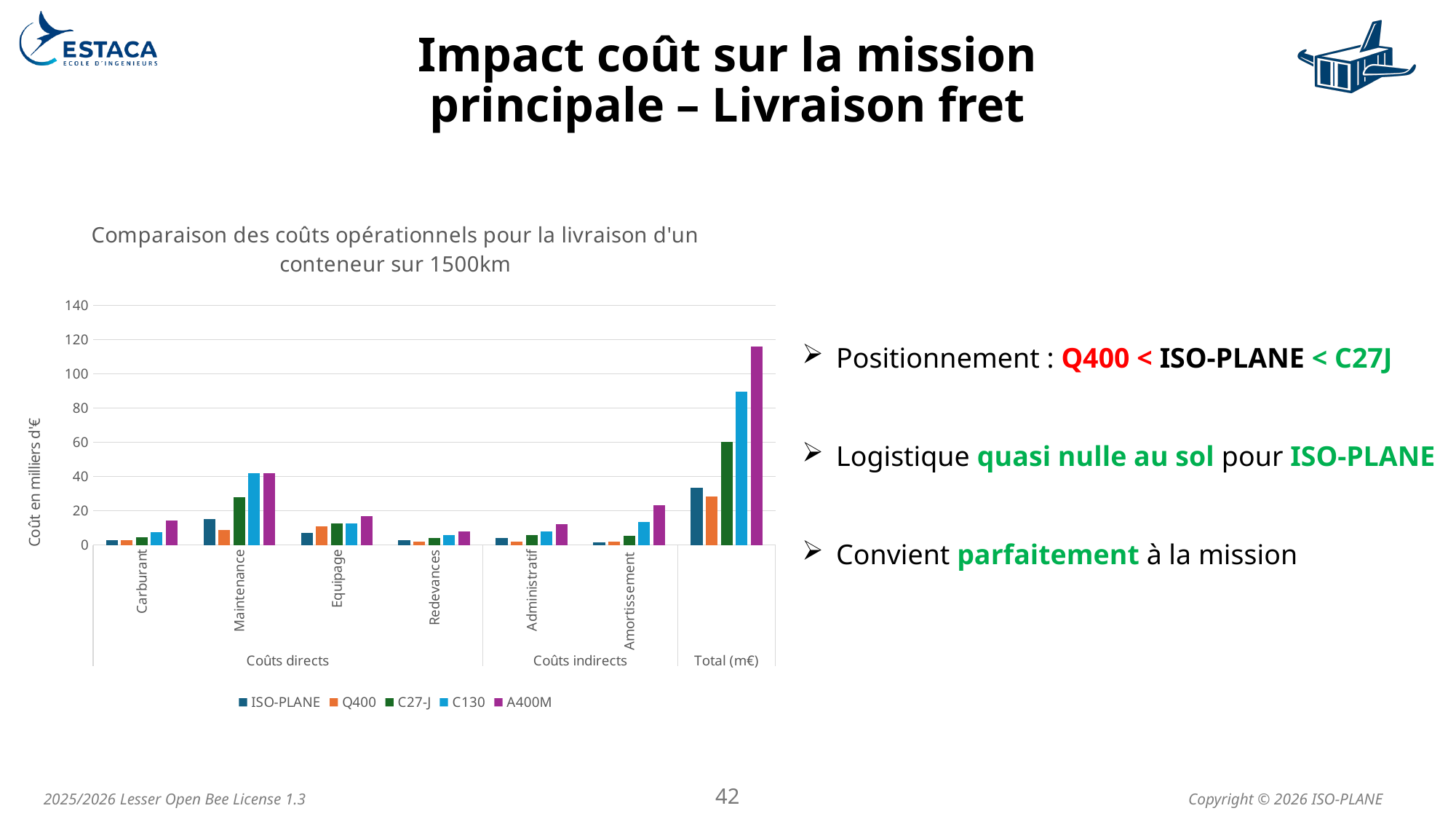
What kind of chart is shown on the slide? bar chart How many cost categories are shown along the x axis of the chart? 7 In the Total (m€) category, which is larger: the value for C130 or the value for C27-J? C130 In the Maintenance category, which is larger: the value for C27-J or the value for ISO-PLANE? C27-J Is the Total (m€) value for A400M greater or less than 100? greater Which aircraft has the highest value in the Total (m€) category? A400M How many series does the chart legend list? 5 Is the Total (m€) value for ISO-PLANE greater or less than 40? less Is the Total (m€) value for C130 greater or less than 80? greater Which aircraft has the lowest value in the Total (m€) category? Q400 What is the label of the vertical axis of the chart? Coût en milliers d'€